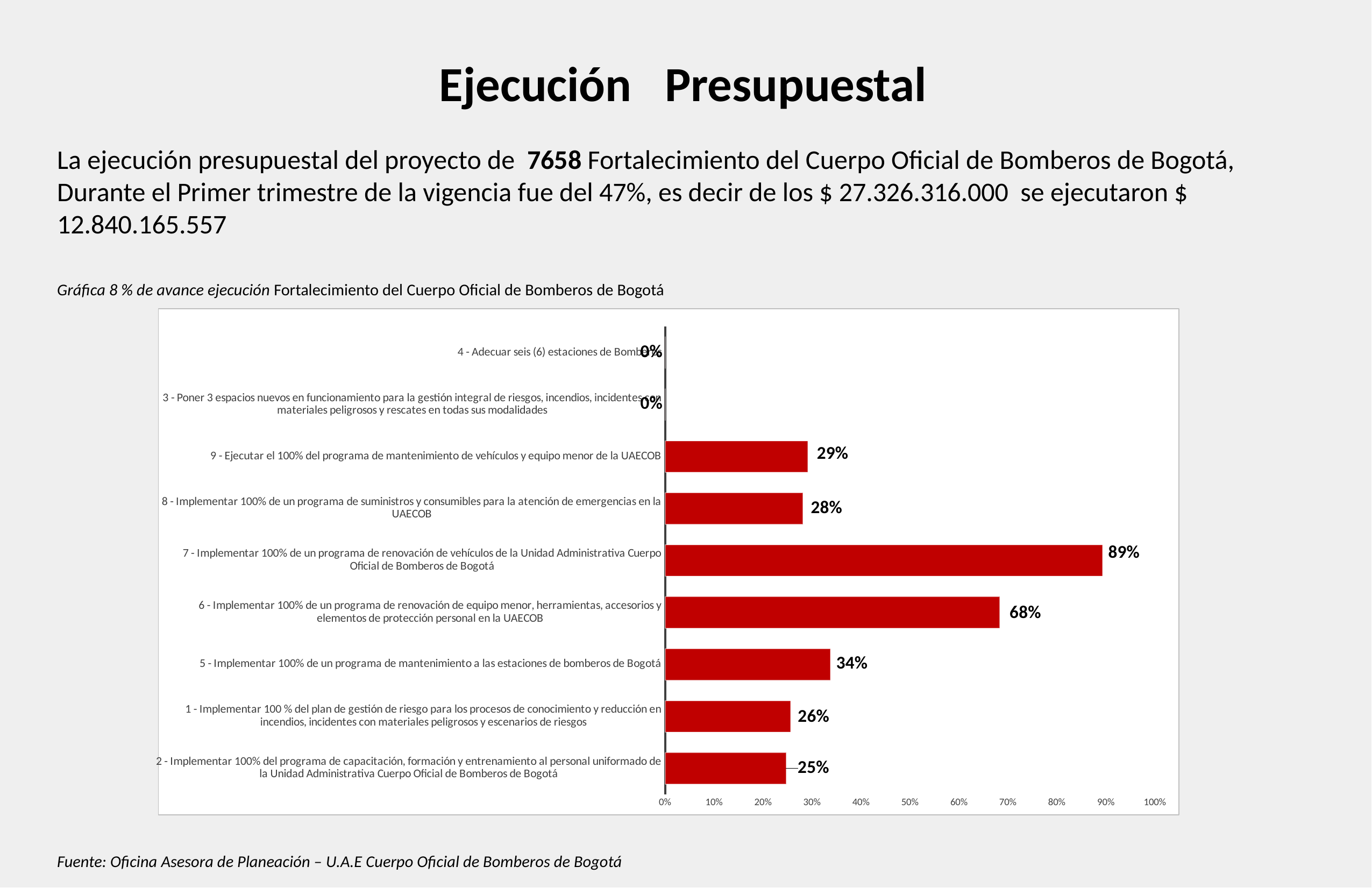
What is the value shown for goal 5, 'Implementar 100% de un programa de mantenimiento a las estaciones de bomberos de Bogotá'? 34% What type of chart is shown on the slide? Bar chart Which goal has the highest percentage of execution progress in the chart? 7 - Implementar 100% de un programa de renovación de vehículos de la Unidad Administrativa Cuerpo Oficial de Bomberos de Bogotá How many goals in the chart show a value of 0%? 2 How many goals (categories) are plotted in the chart? 9 What is the value shown for goal 2, 'Implementar 100% del programa de capacitación, formación y entrenamiento al personal uniformado'? 25% What is the value shown for goal 7, 'Implementar 100% de un programa de renovación de vehículos de la Unidad Administrativa Cuerpo Oficial de Bomberos de Bogotá'? 89% What is the maximum value shown on the horizontal axis of the chart? 100% What is the difference between the values for goal 7 (renovación de vehículos) and goal 6 (renovación de equipo menor)? 21% What is the value shown for goal 4, 'Adecuar seis (6) estaciones de Bomberos'? 0% Which is larger: the value for goal 9 (mantenimiento de vehículos y equipo menor) or goal 8 (programa de suministros y consumibles)? Goal 9 (29%) Is the value for goal 6, 'Implementar 100% de un programa de renovación de equipo menor, herramientas, accesorios y elementos de protección personal', greater or less than 60%? greater